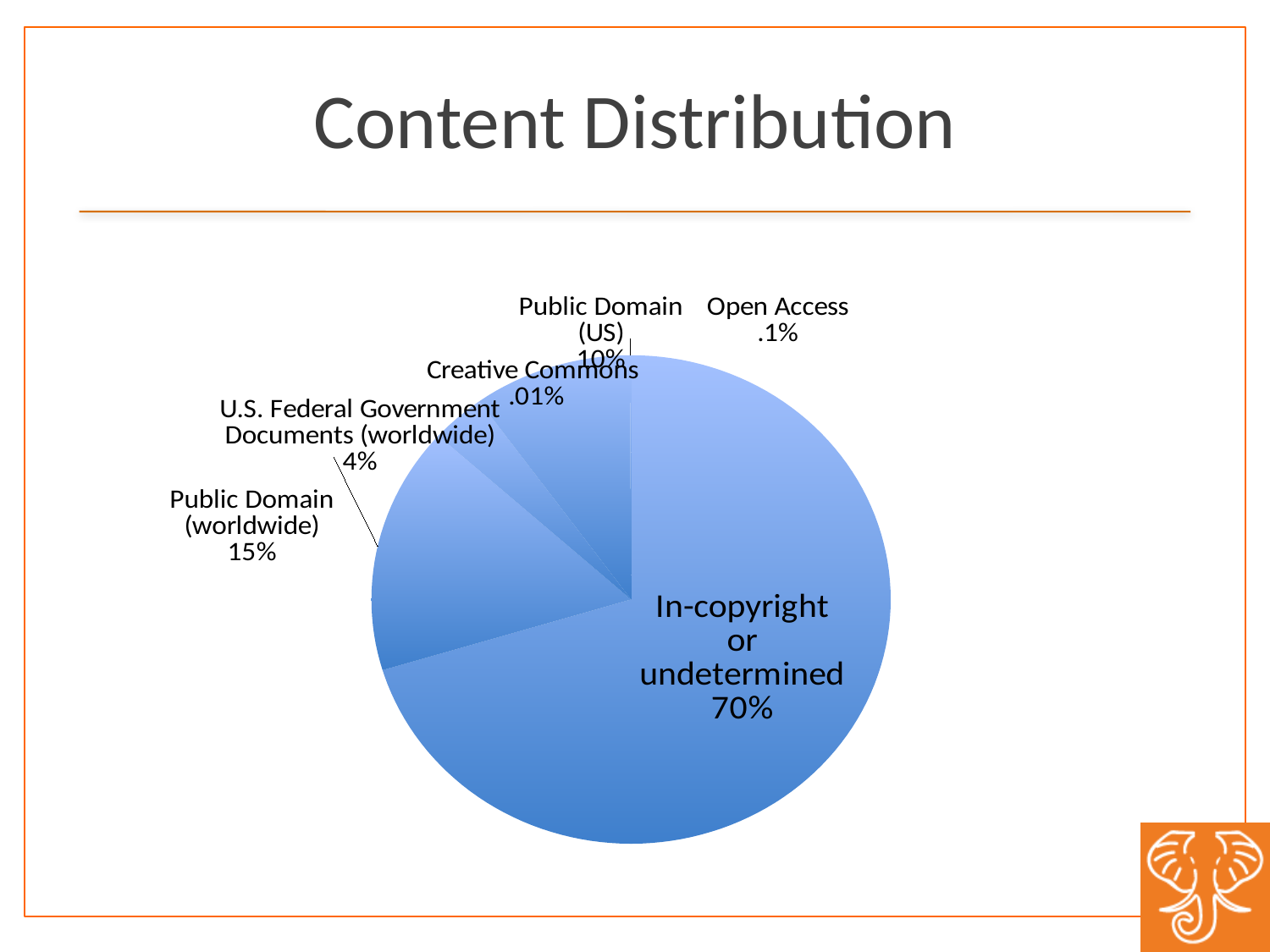
Which category has the largest slice of the pie? In-copyright or undetermined What share of the pie is Public Domain (worldwide)? 15% What share of the pie is Creative Commons? .01% What share of the pie is In-copyright or undetermined? 70% Which is larger, Public Domain (worldwide) or U.S. Federal Government Documents (worldwide)? Public Domain (worldwide) How many categories are shown in the pie chart? 6 What is the title of the chart? Content Distribution Which category has the smallest slice of the pie? Creative Commons What is the difference between the In-copyright or undetermined share and the Public Domain (worldwide) share? 55% What kind of chart is shown on the slide? pie chart